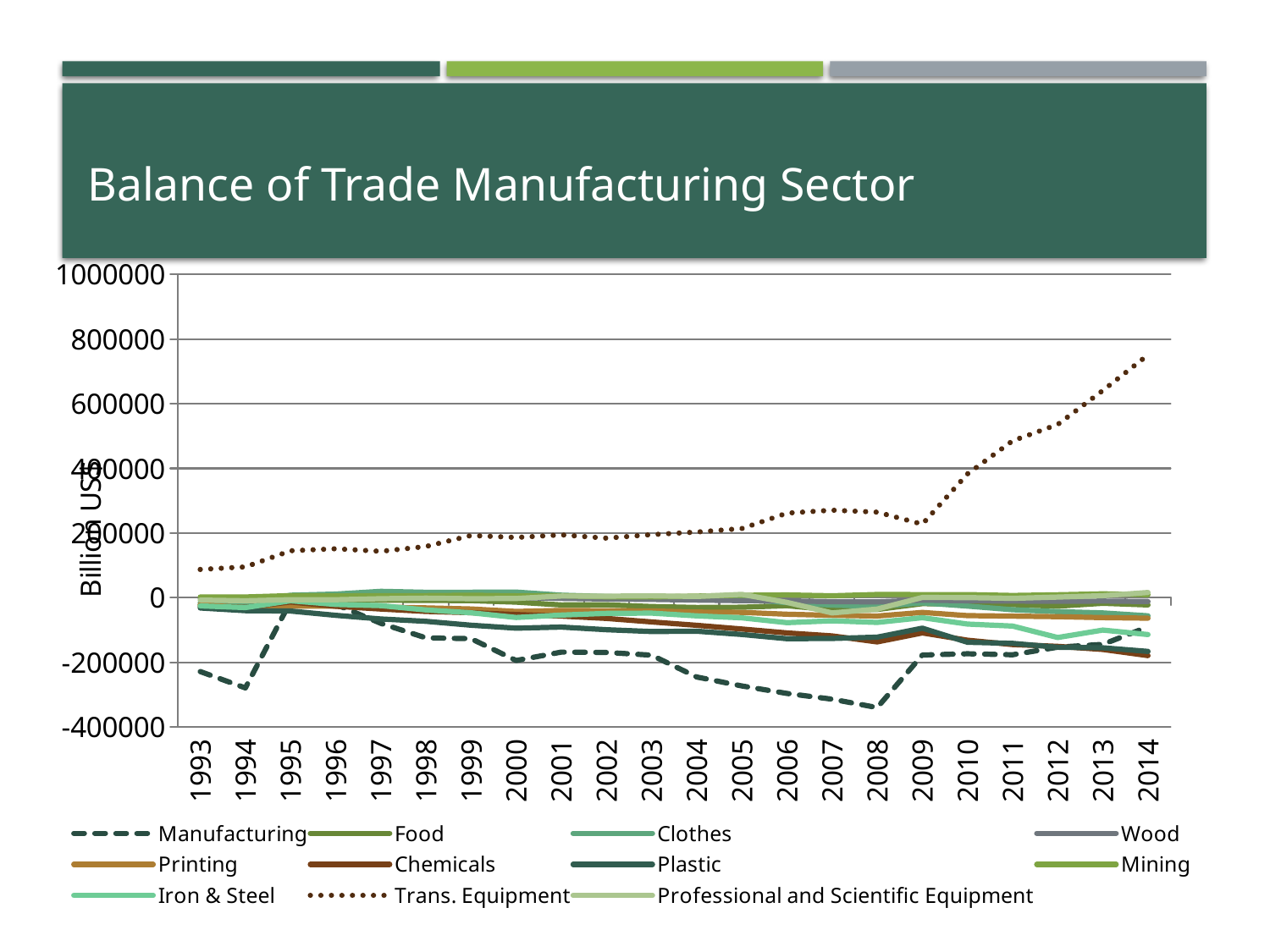
What kind of chart is shown on the slide? line chart How many series does the legend list? 11 Does the Trans. Equipment series overall rise or fall from 1993 to 2014? rise Is the value for Trans. Equipment in 2014 greater or less than 600000? greater What is the label on the vertical axis? Billion US$ How many years are plotted along the x axis? 22 In which year does the Manufacturing series reach its lowest value? 2008 What is the title of the chart? Balance of Trade Manufacturing Sector Which series has the highest value in 2014? Trans. Equipment Is the value for Manufacturing in 2008 greater or less than -200000? less Which is larger, the Trans. Equipment value in 1993 or in 2014? 2014 In which year does the Trans. Equipment series reach its highest value? 2014